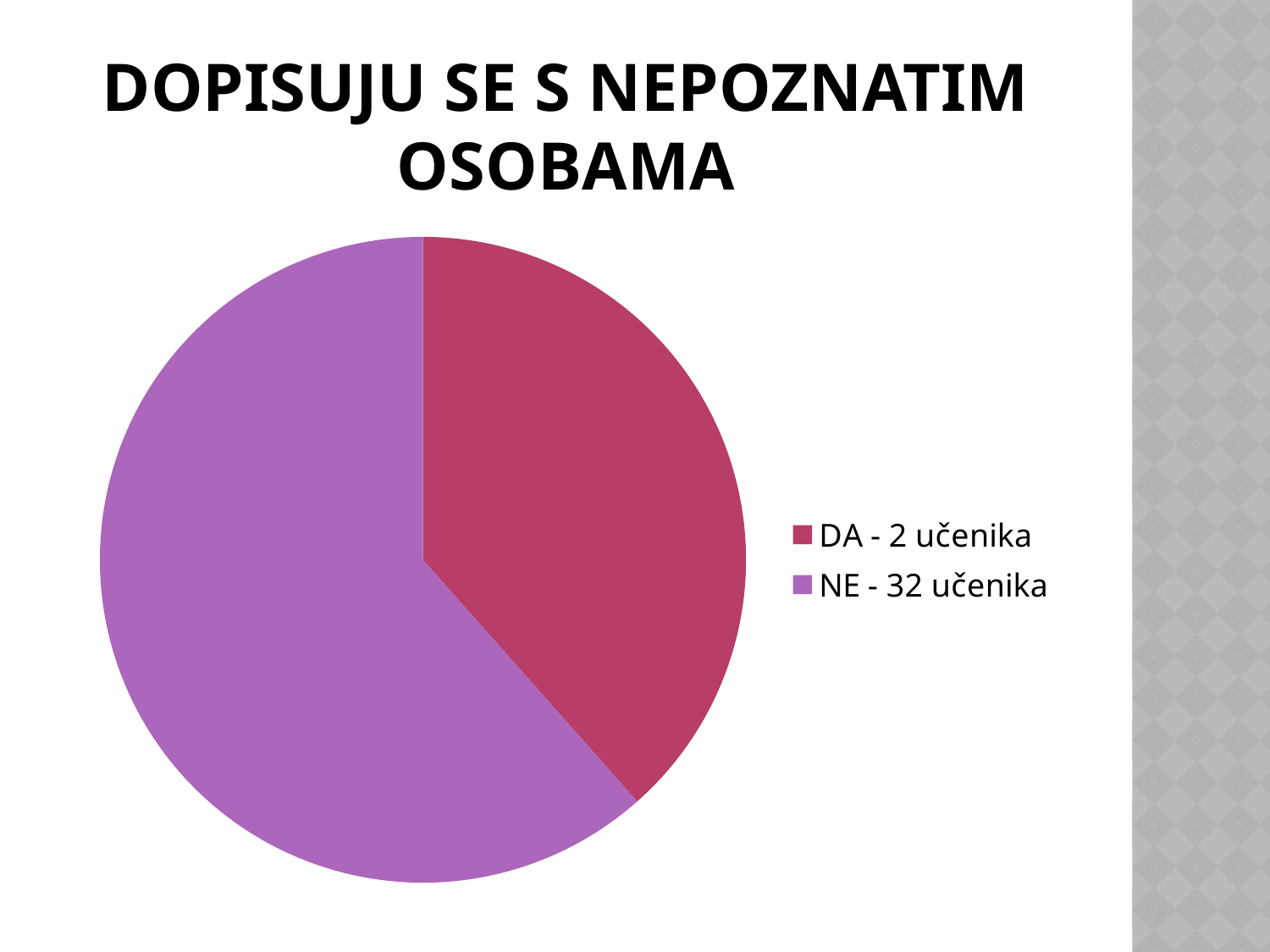
What colour is the slice for NE - 32 učenika? purple How many entries does the legend list? 2 How many slices does the pie chart have? 2 How many students answered NE according to the legend? 32 učenika Which category has the larger slice of the pie? NE - 32 učenika What kind of chart is shown on the slide? pie chart How many students answered DA according to the legend? 2 učenika Which category has the smaller slice of the pie? DA - 2 učenika What is the difference between the number of students for NE and for DA? 30 What is the title of the chart? DOPISUJU SE S NEPOZNATIM OSOBAMA Which is larger, the number of students for DA or for NE? NE